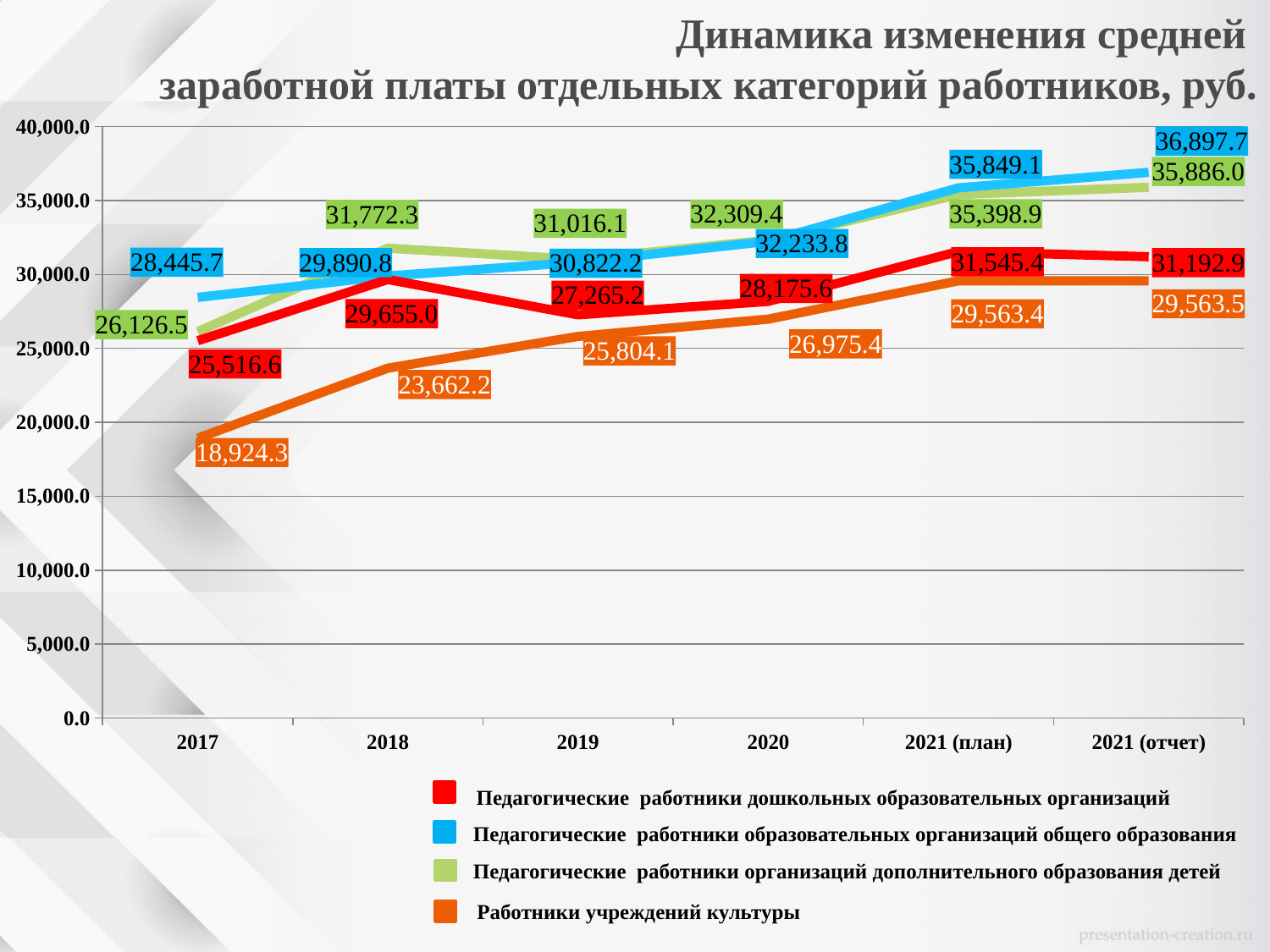
What is the value for Педагогические работники организаций дополнительного образования детей in 2020? 32,309.4 In which period is the value for Работники учреждений культуры the lowest? 2017 In which period is the value for Педагогические работники образовательных организаций общего образования the highest? 2021 (отчет) How many series does the legend list? 4 In 2018, which is larger: the value for Педагогические работники организаций дополнительного образования детей or for Педагогические работники образовательных организаций общего образования? Педагогические работники организаций дополнительного образования детей What is the difference between the 2021 (отчет) and 2021 (план) values for Педагогические работники образовательных организаций общего образования? 1,048.6 Does the value for Работники учреждений культуры rise or fall from 2017 to 2021 (план)? Rises What is the value for Педагогические работники образовательных организаций общего образования in 2021 (отчет)? 36,897.7 What is the value for Педагогические работники дошкольных образовательных организаций in 2019? 27,265.2 How many periods are shown on the x axis? 6 What is the value for Работники учреждений культуры in 2017? 18,924.3 What kind of chart is shown on the slide? Line chart